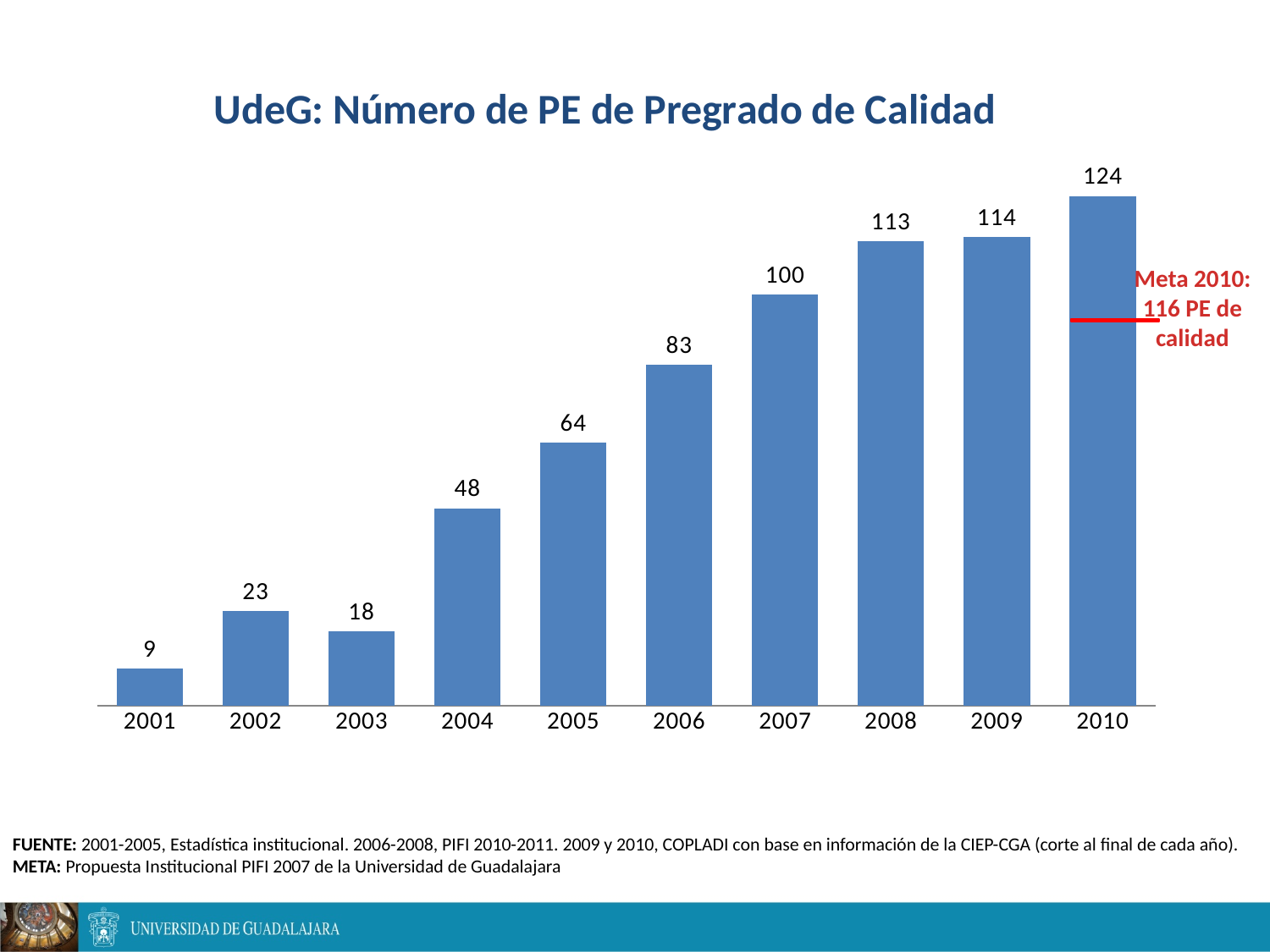
Which year has the lowest value? 2001 What is the value for 2001? 9 How many years are shown on the x axis? 10 What kind of chart is this? Bar chart What is the difference between the values for 2010 and 2009? 10 What is the difference between the values for 2006 and 2005? 19 What is the value for 2007? 100 Which is larger, the value for 2002 or the value for 2003? 2002 Which year has the highest value? 2010 What is the value for 2004? 48 What is the title of the chart? UdeG: Número de PE de Pregrado de Calidad Do the values generally rise or fall from 2003 to 2010? Rise